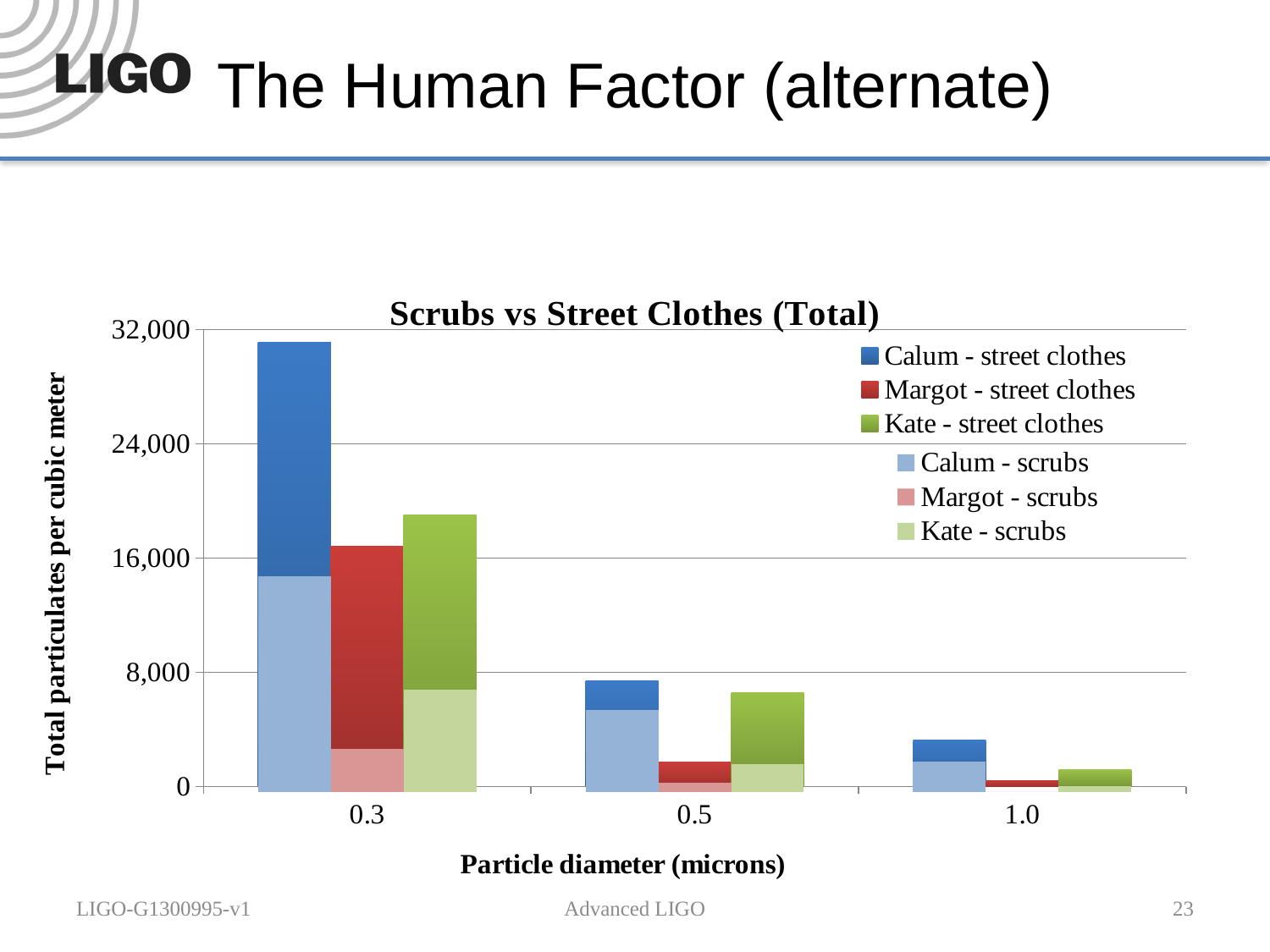
Is the value for Calum - street clothes at 0.5 microns greater or less than 16,000? less What kind of chart is shown on the slide? bar chart How many particle diameter categories are shown on the x axis? 3 Is the value for Kate - street clothes at 0.3 microns greater or less than 24,000? less Do the values for Calum - street clothes rise or fall as particle diameter increases from 0.3 to 1.0 microns? fall What is the title of the chart? Scrubs vs Street Clothes (Total) At 0.3 microns, which is larger: Calum - street clothes or Margot - street clothes? Calum - street clothes Is the value for Calum - street clothes at 0.3 microns greater or less than 24,000? greater At which particle diameter is the value for Calum - street clothes highest? 0.3 What is the label of the y axis? Total particulates per cubic meter How many series does the chart legend list? 6